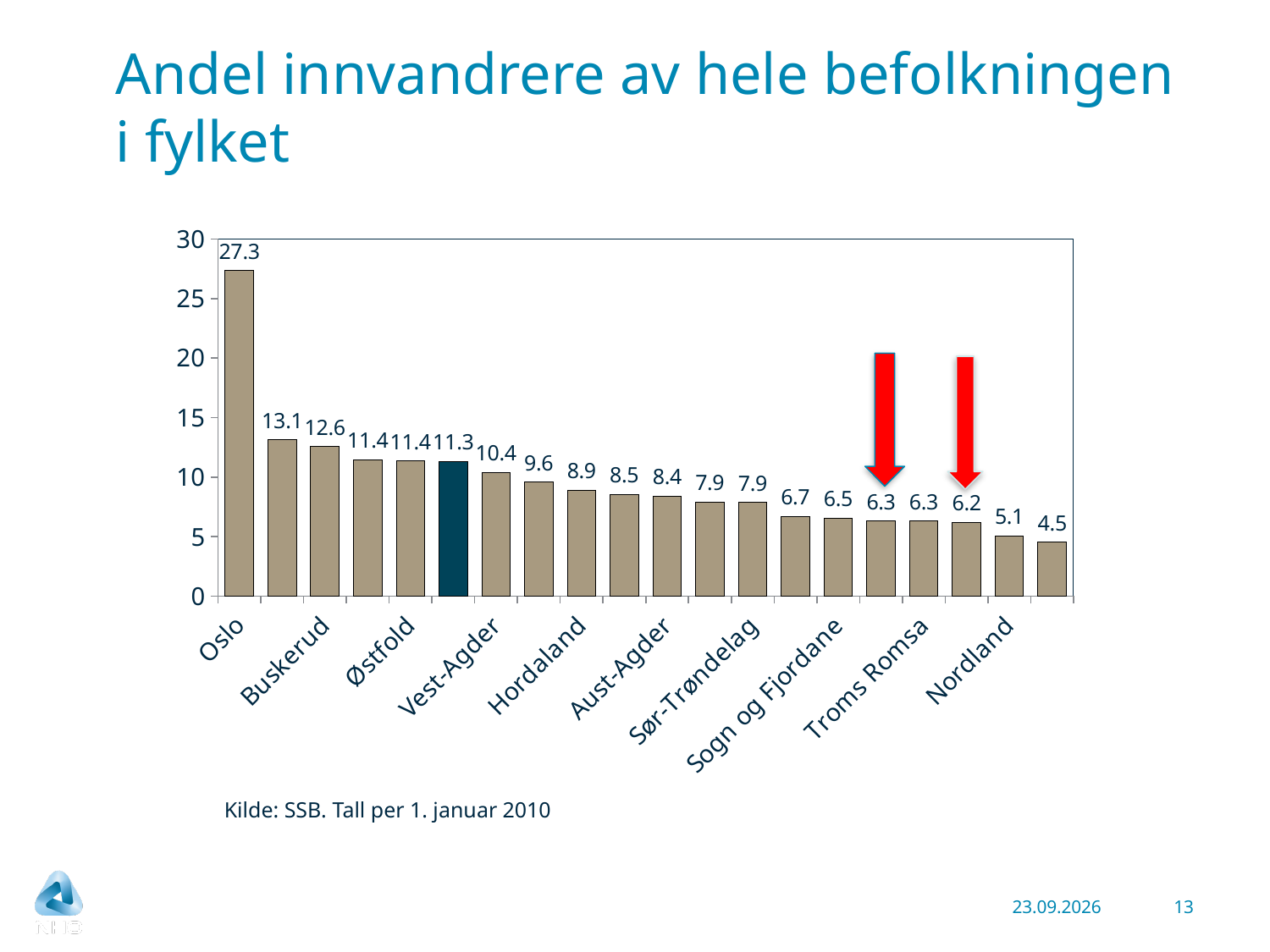
How many bars are plotted in the chart? 20 What type of chart is shown on the slide? bar chart What is the lowest value shown in the chart? 4.5 Is the value for Oslo greater or less than 25? greater What is the value for Nordland? 5.1 What is the value for Vest-Agder? 10.4 What is the value for Buskerud? 12.6 Do the values rise or fall from left to right along the x axis? fall Which has a larger value, Hordaland or Sør-Trøndelag? Hordaland Which county has the highest share of immigrants? Oslo What is the value for Oslo? 27.3 What is the difference between the values for Oslo and Buskerud? 14.7